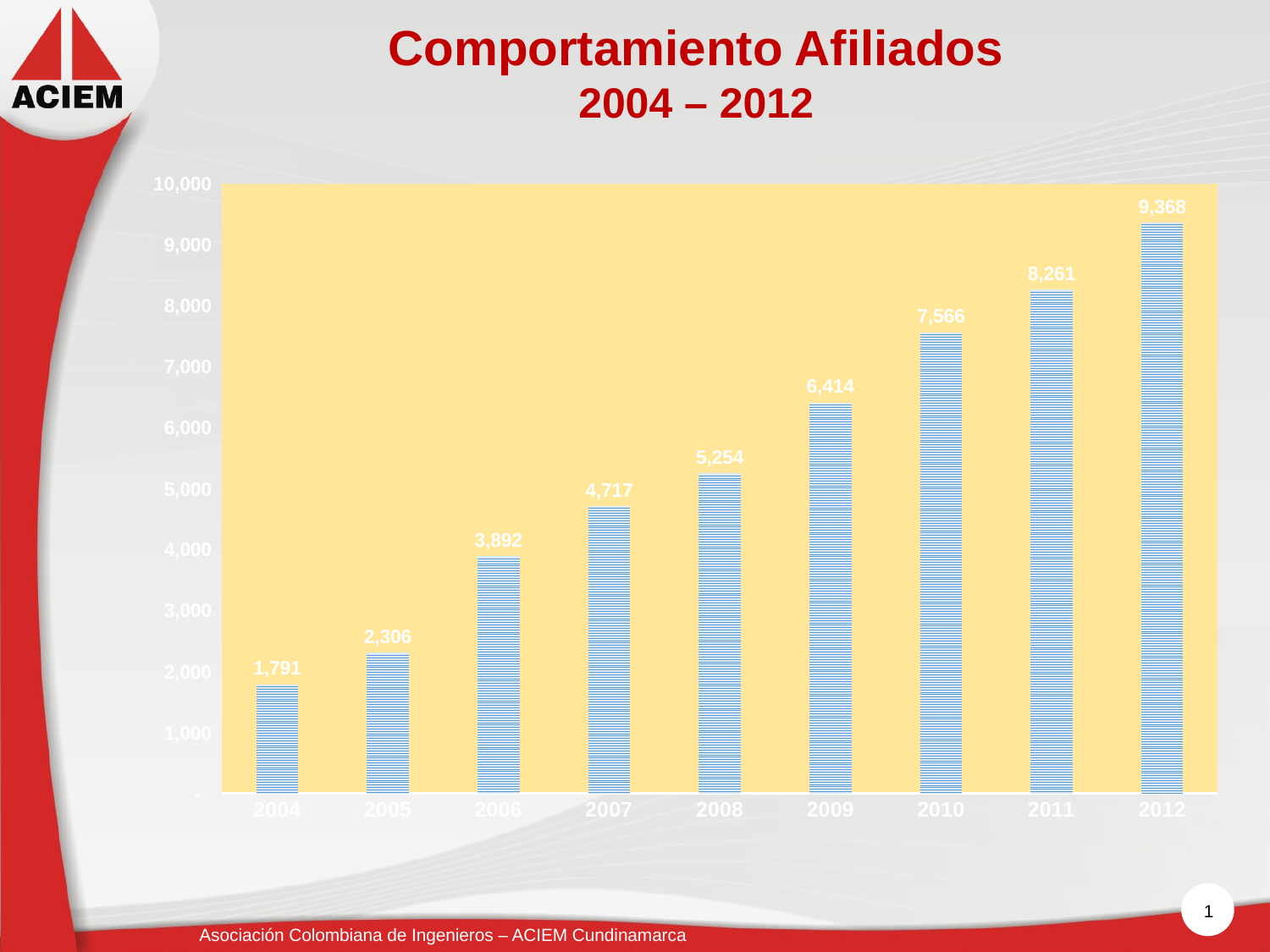
Which year has the highest value? 2012 What is the value for 2011? 8,261 What is the difference between the values for 2006 and 2005? 1,586 What is the value for 2008? 5,254 What is the value for 2004? 1,791 How many years are shown on the x axis? 9 Is the value for 2010 greater or less than 7,000? greater What is the difference between the values for 2012 and 2011? 1,107 What kind of chart is shown on the slide? bar chart Do the values rise or fall from 2004 to 2012? rise Which year has the lowest value? 2004 Which is larger, the value for 2009 or the value for 2007? 2009